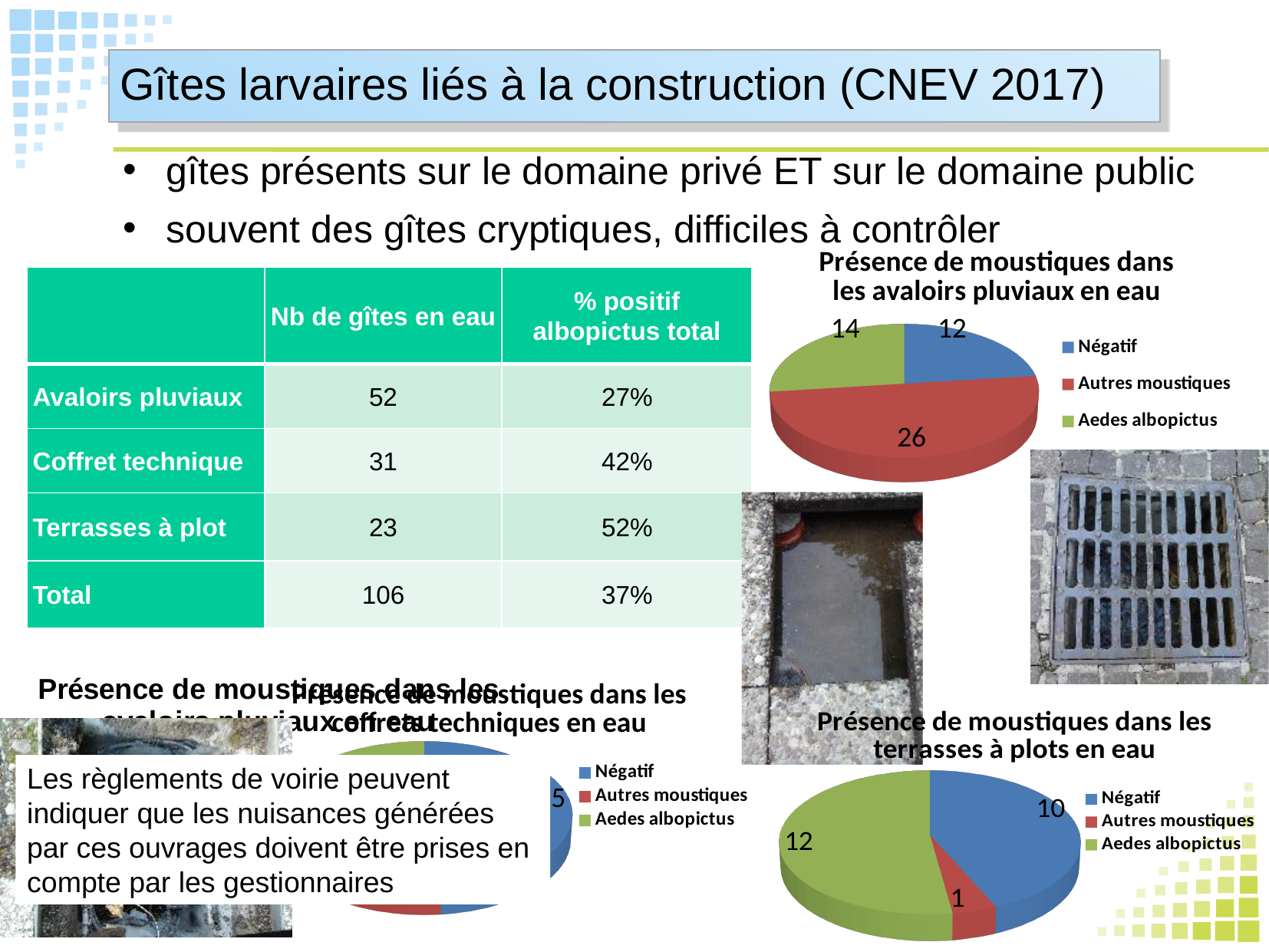
In the chart 'Présence de moustiques dans les terrasses à plots en eau', what colour is the Négatif slice? Blue In the chart 'Présence de moustiques dans les terrasses à plots en eau', which is larger, Négatif or Aedes albopictus? Aedes albopictus In the chart 'Présence de moustiques dans les avaloirs pluviaux en eau', which category has the largest slice? Autres moustiques What kind of chart is 'Présence de moustiques dans les avaloirs pluviaux en eau'? Pie chart In the chart 'Présence de moustiques dans les terrasses à plots en eau', which category has the smallest slice? Autres moustiques In the chart 'Présence de moustiques dans les terrasses à plots en eau', what is the value for Aedes albopictus? 12 In the chart 'Présence de moustiques dans les avaloirs pluviaux en eau', what is the value for Aedes albopictus? 14 In the chart 'Présence de moustiques dans les avaloirs pluviaux en eau', what is the value for Négatif? 12 In the chart 'Présence de moustiques dans les terrasses à plots en eau', what is the value for Autres moustiques? 1 In the chart 'Présence de moustiques dans les avaloirs pluviaux en eau', what is the difference between Autres moustiques and Négatif? 14 In the chart 'Présence de moustiques dans les avaloirs pluviaux en eau', what is the value for Autres moustiques? 26 How many entries does the legend of the chart 'Présence de moustiques dans les avaloirs pluviaux en eau' list? 3